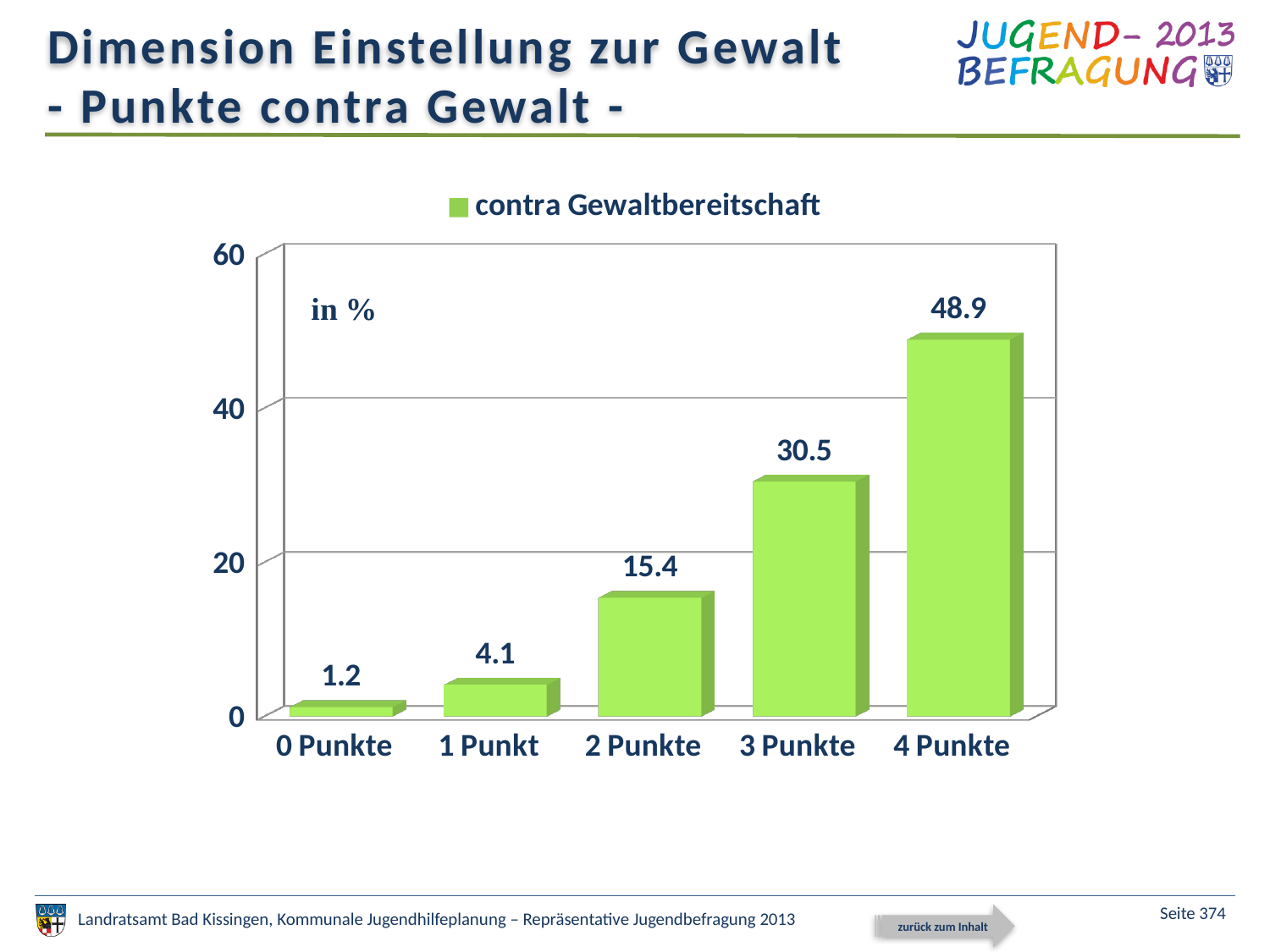
What is the value for 4 Punkte? 48.9 Which category has the highest value? 4 Punkte What is the difference between the values for 4 Punkte and 3 Punkte? 18.4 What is the value for 1 Punkt? 4.1 How many categories are shown on the x axis? 5 What kind of chart is shown? bar chart Is the value for 3 Punkte greater or less than 40? less What is the value for 2 Punkte? 15.4 Which is larger, the value for 2 Punkte or the value for 3 Punkte? 3 Punkte How many series does the legend list? 1 Which category has the lowest value? 0 Punkte Do the values rise or fall from 0 Punkte to 4 Punkte? rise